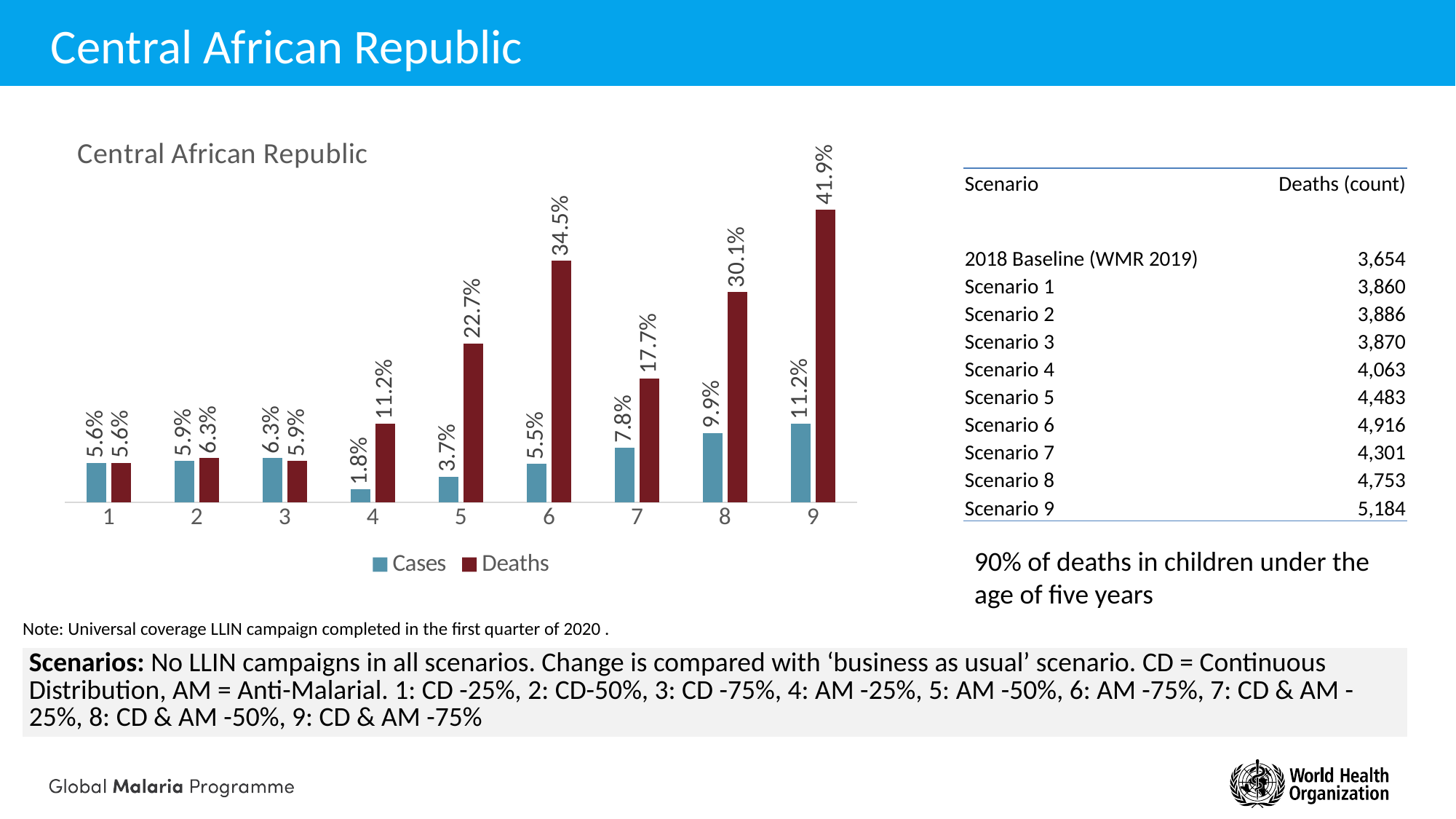
What is the Deaths value for scenario 6? 34.5% Which scenario has the highest Deaths value? 9 How many scenarios are shown on the x axis of the chart? 9 Which scenario has the lowest Cases value? 4 What is the difference between the Deaths value and the Cases value for scenario 8? 20.2% Do the Cases values rise or fall from scenario 7 to scenario 9? Rise Which is larger for scenario 5: the Cases value or the Deaths value? Deaths What kind of chart is shown on the slide? Bar chart How many series does the chart legend list? 2 What is the title of the chart? Central African Republic What is the Deaths value for scenario 9? 41.9% What is the Cases value for scenario 4? 1.8%